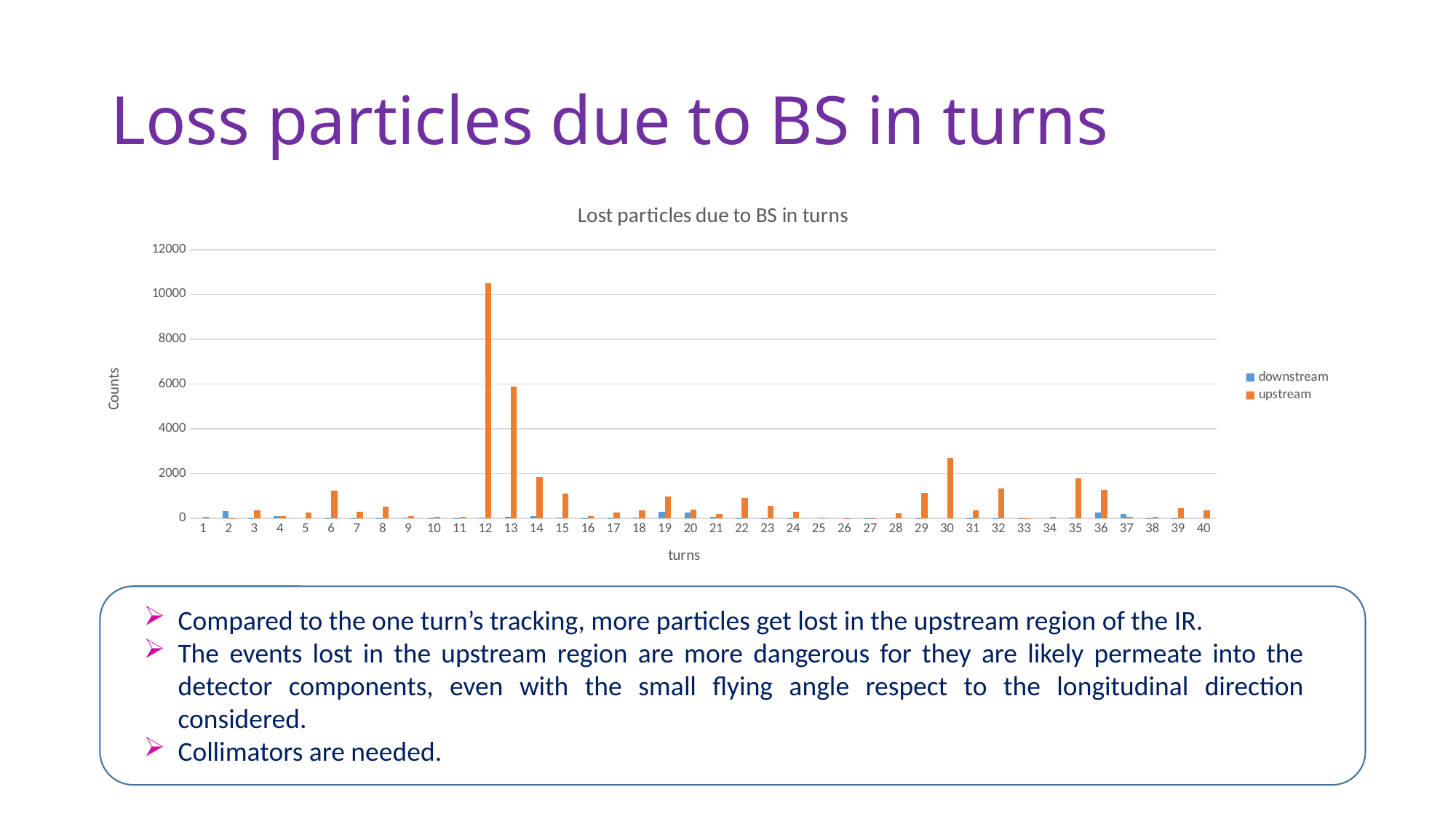
What kind of chart is shown on the slide? Bar chart Which colour represents the upstream series in the chart? Orange Is the upstream value at turn 13 greater or less than 4000? greater Which has the larger upstream count, turn 12 or turn 13? Turn 12 Is the upstream value at turn 6 greater or less than 2000? less Is the upstream value at turn 30 greater or less than 2000? greater At turn 12, which series has the larger value, downstream or upstream? Upstream How many turns are shown along the x axis of the chart? 40 What is the title of the chart? Lost particles due to BS in turns How many series does the chart legend list? 2 At which turn is the upstream count highest? 12